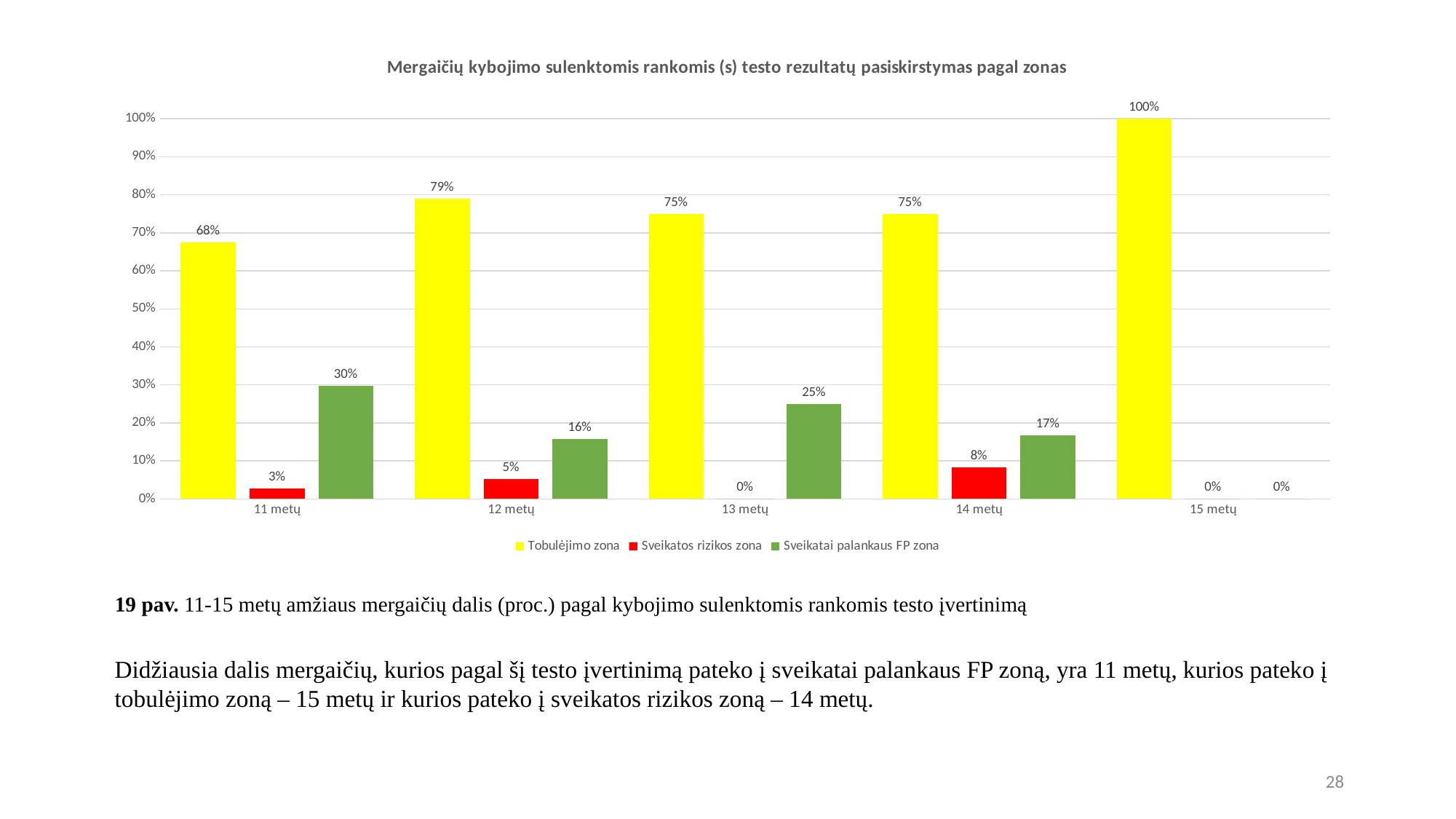
What is the value of Sveikatai palankaus FP zona for 13 metų? 25% How many series does the legend list? 3 What is the value of Tobulėjimo zona for 11 metų? 68% What colour represents Sveikatos rizikos zona in the chart? red Which is larger: Sveikatai palankaus FP zona for 12 metų or for 14 metų? 14 metų What type of chart is shown on the slide? bar chart Which age group has the highest value for Sveikatai palankaus FP zona? 11 metų What is the value of Sveikatos rizikos zona for 14 metų? 8% Which age group has the lowest value for Tobulėjimo zona? 11 metų How many age groups are shown on the x axis? 5 What is the difference between the Tobulėjimo zona values for 12 metų and 11 metų? 11% Which age group has the highest value for Tobulėjimo zona? 15 metų